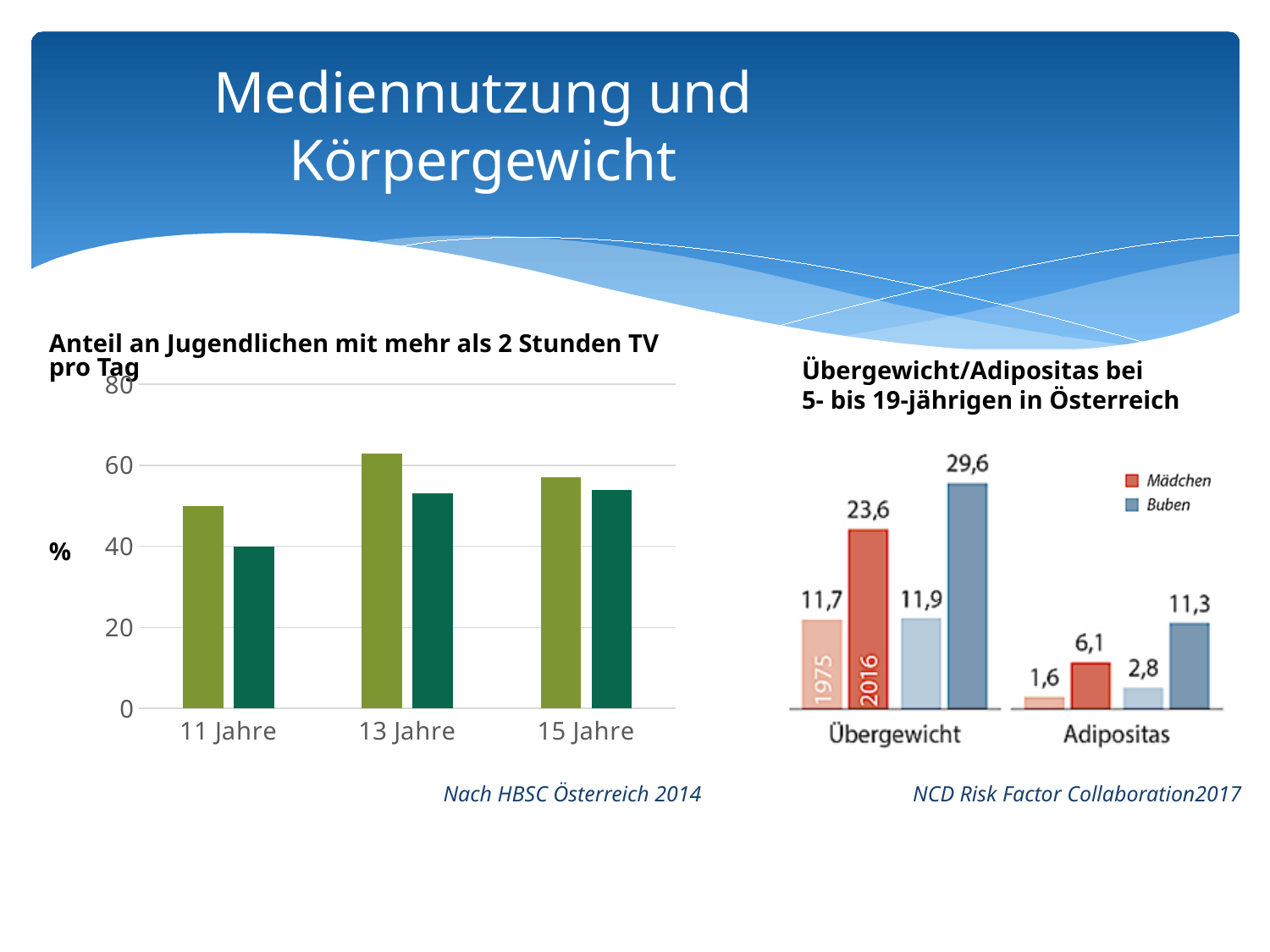
In the chart 'Anteil an Jugendlichen mit mehr als 2 Stunden TV pro Tag', is the value of the light green bar for 13 Jahre greater or less than 60? greater In the chart 'Übergewicht/Adipositas bei 5- bis 19-jährigen in Österreich', by how much did the Übergewicht value for Buben increase from 1975 to 2016? 17,7 In the chart 'Übergewicht/Adipositas bei 5- bis 19-jährigen in Österreich', what is the value for Mädchen in 2016 for Adipositas? 6,1 What kind of chart is 'Anteil an Jugendlichen mit mehr als 2 Stunden TV pro Tag'? Bar chart In the chart 'Anteil an Jugendlichen mit mehr als 2 Stunden TV pro Tag', how many age categories are shown on the x axis? 3 In the chart 'Übergewicht/Adipositas bei 5- bis 19-jährigen in Österreich', what is the difference between the 2016 Adipositas values for Buben and Mädchen? 5,2 In the chart 'Übergewicht/Adipositas bei 5- bis 19-jährigen in Österreich', what is the value for Buben in 2016 for Übergewicht? 29,6 In the chart 'Übergewicht/Adipositas bei 5- bis 19-jährigen in Österreich', what is the value for Mädchen in 1975 for Übergewicht? 11,7 In the chart 'Übergewicht/Adipositas bei 5- bis 19-jährigen in Österreich', which bar has the lowest value? Mädchen 1975 Adipositas (1,6) In the chart 'Anteil an Jugendlichen mit mehr als 2 Stunden TV pro Tag', which bar is larger for 13 Jahre, the light green or the dark green one? light green In the chart 'Übergewicht/Adipositas bei 5- bis 19-jährigen in Österreich', which bar has the highest value? Buben 2016 Übergewicht (29,6) In the chart 'Übergewicht/Adipositas bei 5- bis 19-jährigen in Österreich', how many series does the legend list? 2